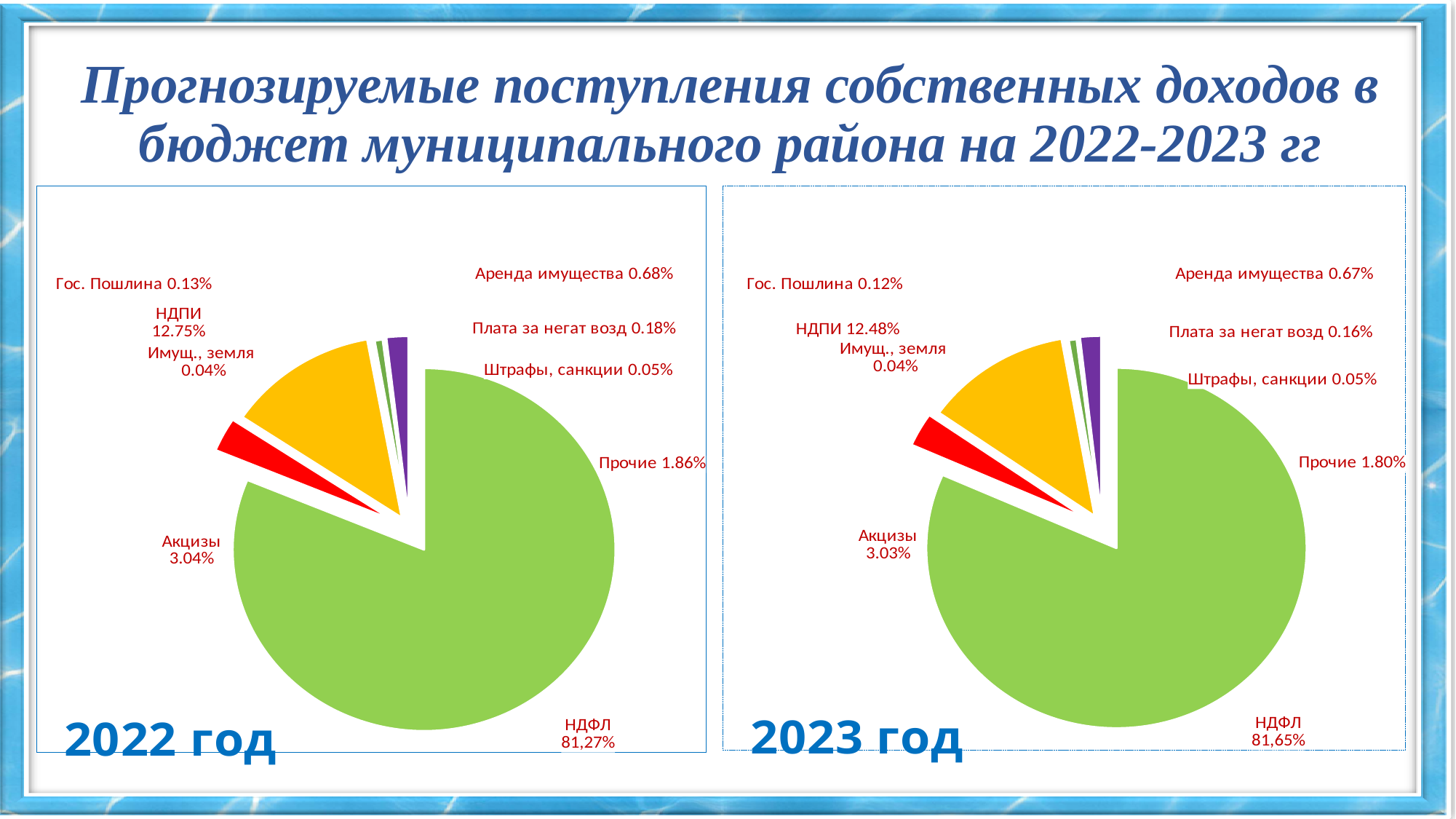
In the 2023 год chart, what is the difference between the shares of НДПИ and Акцизы? 9.45% In the 2023 год chart, what colour is the НДФЛ slice? Green What type of chart is used for 2023 год? Pie chart In the 2022 год chart, which is larger: Аренда имущества or Плата за негат возд? Аренда имущества In the 2023 год chart, what is the value for Прочие? 1.80% In the 2022 год chart, what share does НДФЛ have? 81,27% In the 2023 год chart, which category has the smallest share? Имущ., земля In the 2022 год chart, which category has the largest share? НДФЛ How many categories are shown in the 2022 год chart? 9 In the 2023 год chart, what share does НДПИ have? 12.48% In the 2022 год chart, what is the value for Акцизы? 3.04% In the 2022 год chart, what is the value for Гос. Пошлина? 0.13%